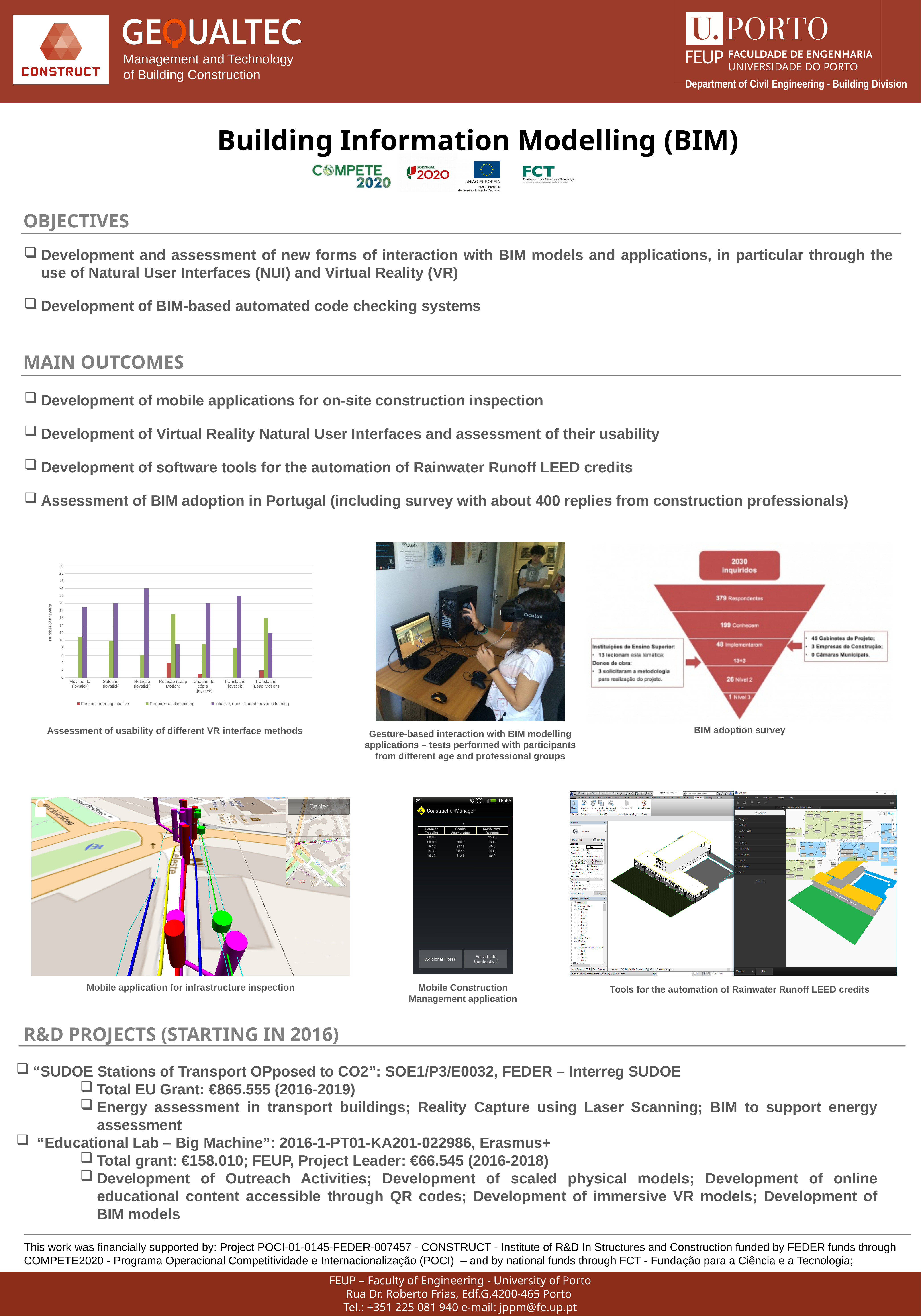
In the 'Assessment of usability of different VR interface methods' chart, is the 'Requires a little training' value for Rotação (joystick) greater or less than 10? less In the 'Assessment of usability of different VR interface methods' chart, which category has the highest value for 'Far from beening intuitive'? Rotação (Leap Motion) How many series does the legend of the 'Assessment of usability of different VR interface methods' chart list? 3 In the 'Assessment of usability of different VR interface methods' chart, for Rotação (Leap Motion), which is larger: 'Requires a little training' or 'Intuitive, doesn't need previous training'? Requires a little training In the 'Assessment of usability of different VR interface methods' chart, for Movimento (joystick), which is larger: 'Requires a little training' or 'Intuitive, doesn't need previous training'? Intuitive, doesn't need previous training In the 'Assessment of usability of different VR interface methods' chart, which category has the highest value for 'Intuitive, doesn't need previous training'? Rotação (joystick) In the 'Assessment of usability of different VR interface methods' chart, is the 'Requires a little training' value for Rotação (Leap Motion) greater or less than 14? greater How many interface method categories are shown on the x axis of the 'Assessment of usability of different VR interface methods' chart? 7 In the 'Assessment of usability of different VR interface methods' chart, which series is shown in red? Far from beening intuitive What kind of chart is 'Assessment of usability of different VR interface methods'? bar chart In the 'Assessment of usability of different VR interface methods' chart, is the 'Intuitive, doesn't need previous training' value for Rotação (joystick) greater or less than 20? greater What is the y-axis label of the 'Assessment of usability of different VR interface methods' chart? Number of answers